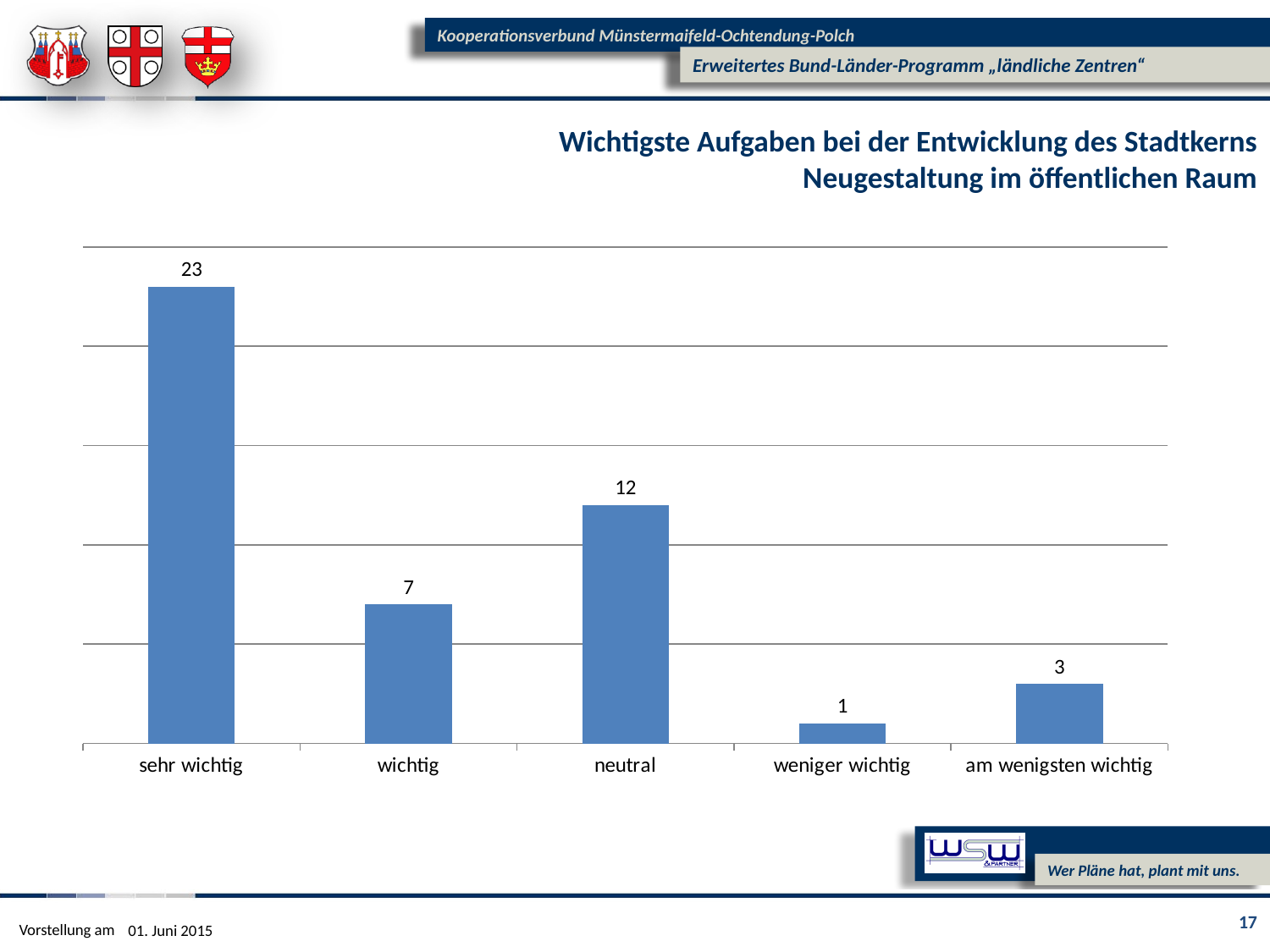
What is the difference between the values for "sehr wichtig" and "neutral"? 11 What is the title of the slide above the chart? Wichtigste Aufgaben bei der Entwicklung des Stadtkerns Neugestaltung im öffentlichen Raum Which category has the lowest value? weniger wichtig How many categories are shown on the x axis? 5 What is the value for "weniger wichtig"? 1 What kind of chart is shown on the slide? bar chart Which is larger, the value for "wichtig" or the value for "neutral"? neutral Which category has the highest value? sehr wichtig What is the value for "am wenigsten wichtig"? 3 What is the value for "wichtig"? 7 What is the value for "sehr wichtig"? 23 What is the value for "neutral"? 12